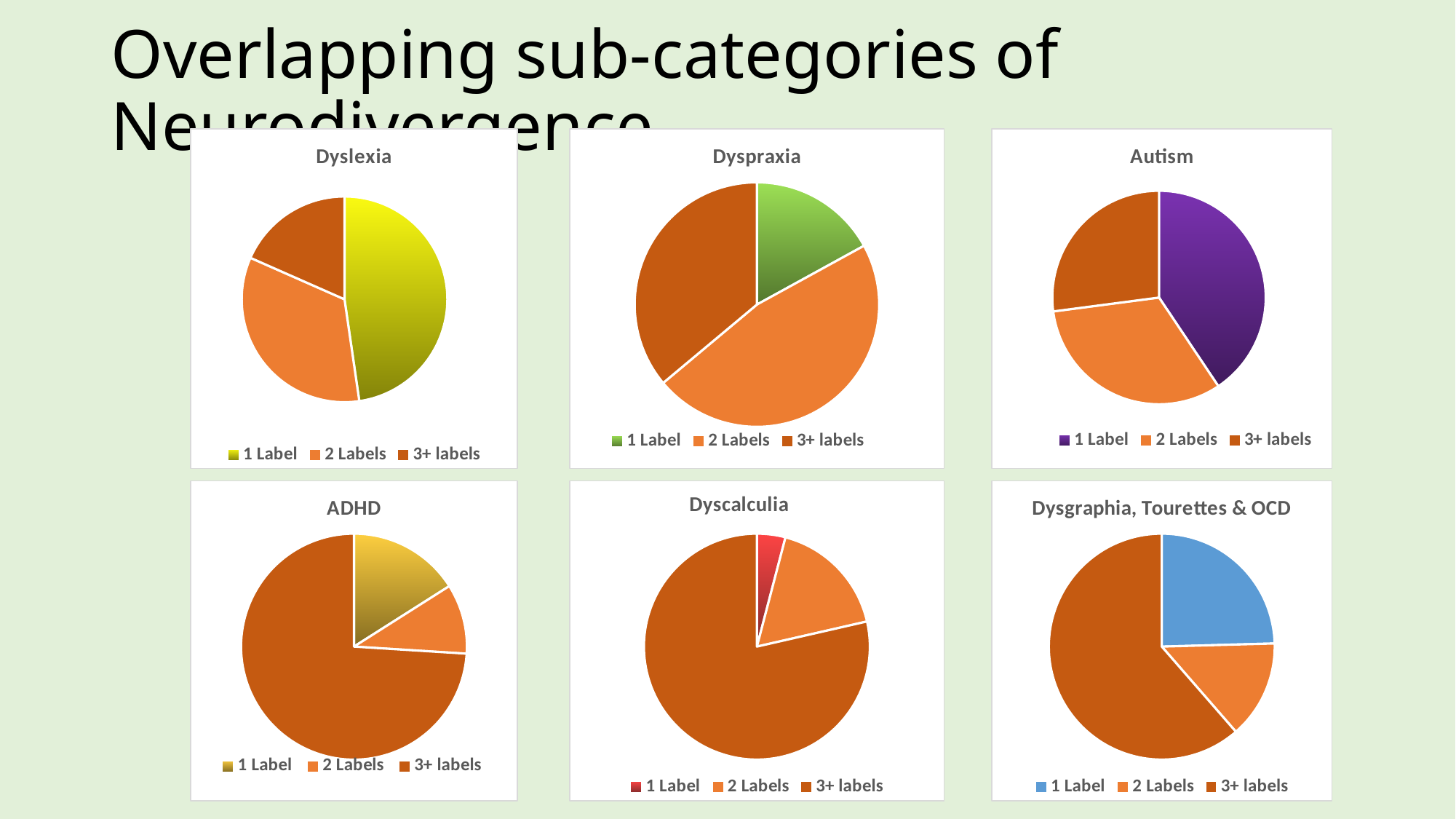
How many entries does the legend of the ADHD chart list? 3 In the Dyscalculia chart, which category has the smallest slice? 1 Label In the ADHD chart, which category has the smallest slice? 2 Labels What kind of chart is the Dyslexia chart? pie chart In the Autism chart, which category has the largest slice? 1 Label In the Dyslexia chart, which category has the largest slice? 1 Label In the Dysgraphia, Tourettes & OCD chart, which is larger: the 1 Label slice or the 2 Labels slice? 1 Label In the Dyspraxia chart, which category has the largest slice? 2 Labels How many pie charts are shown on the slide? 6 In the Dyspraxia chart, which category has the smallest slice? 1 Label What colour is the 1 Label slice in the Autism chart? purple